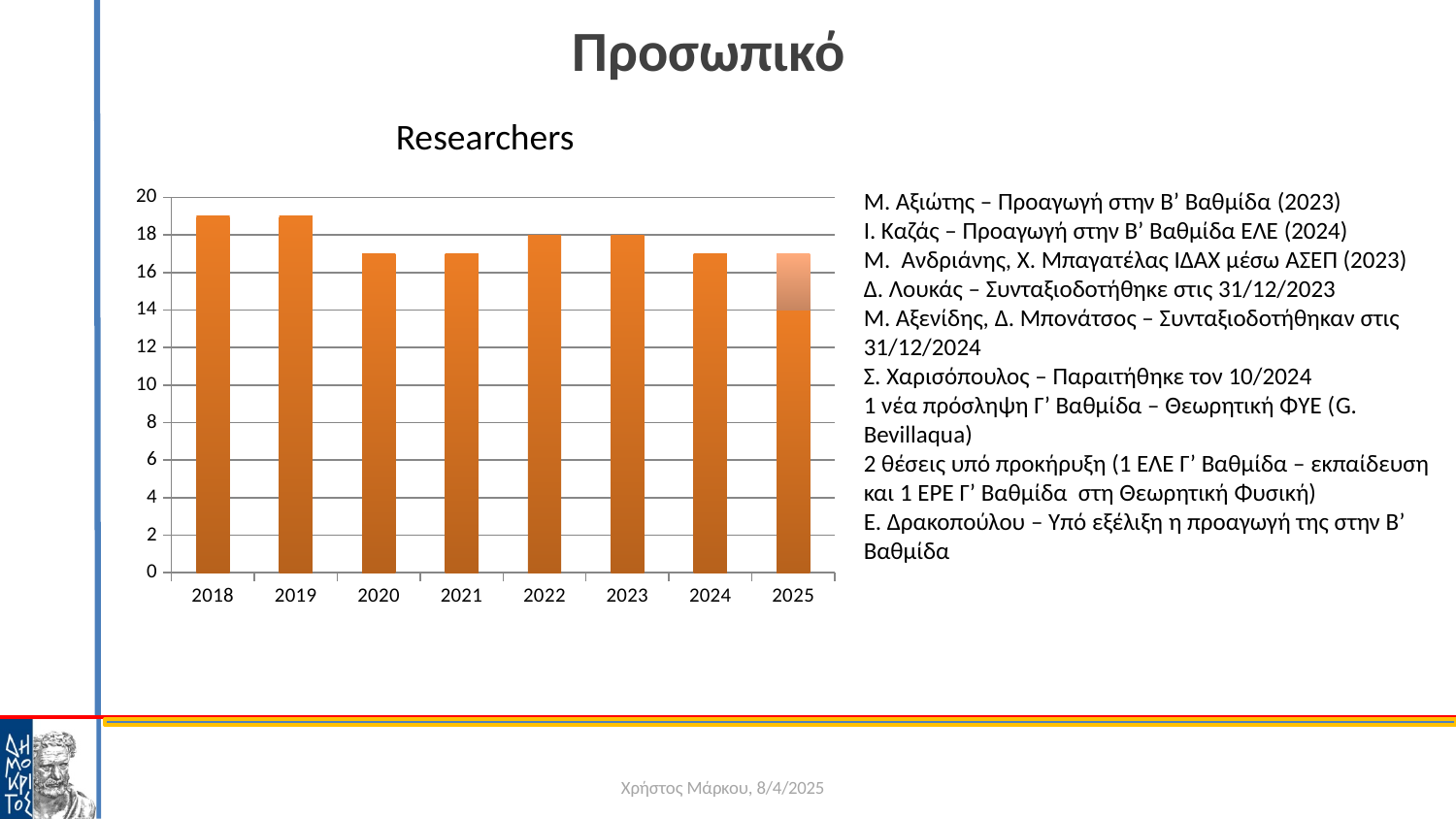
Is the value for 2020 greater or less than 18? less What is the title of the chart? Researchers How many years are shown on the x axis of the chart? 8 Is the value for 2024 greater or less than 16? greater What kind of chart is shown on the slide? bar chart What is the value for 2023? 18 Is the value for 2018 greater or less than 18? greater Overall, do the values rise or fall from 2018 to 2025? fall Which is larger, the value for 2021 or the value for 2022? 2022 Which is larger, the value for 2018 or the value for 2020? 2018 What is the value for 2022? 18